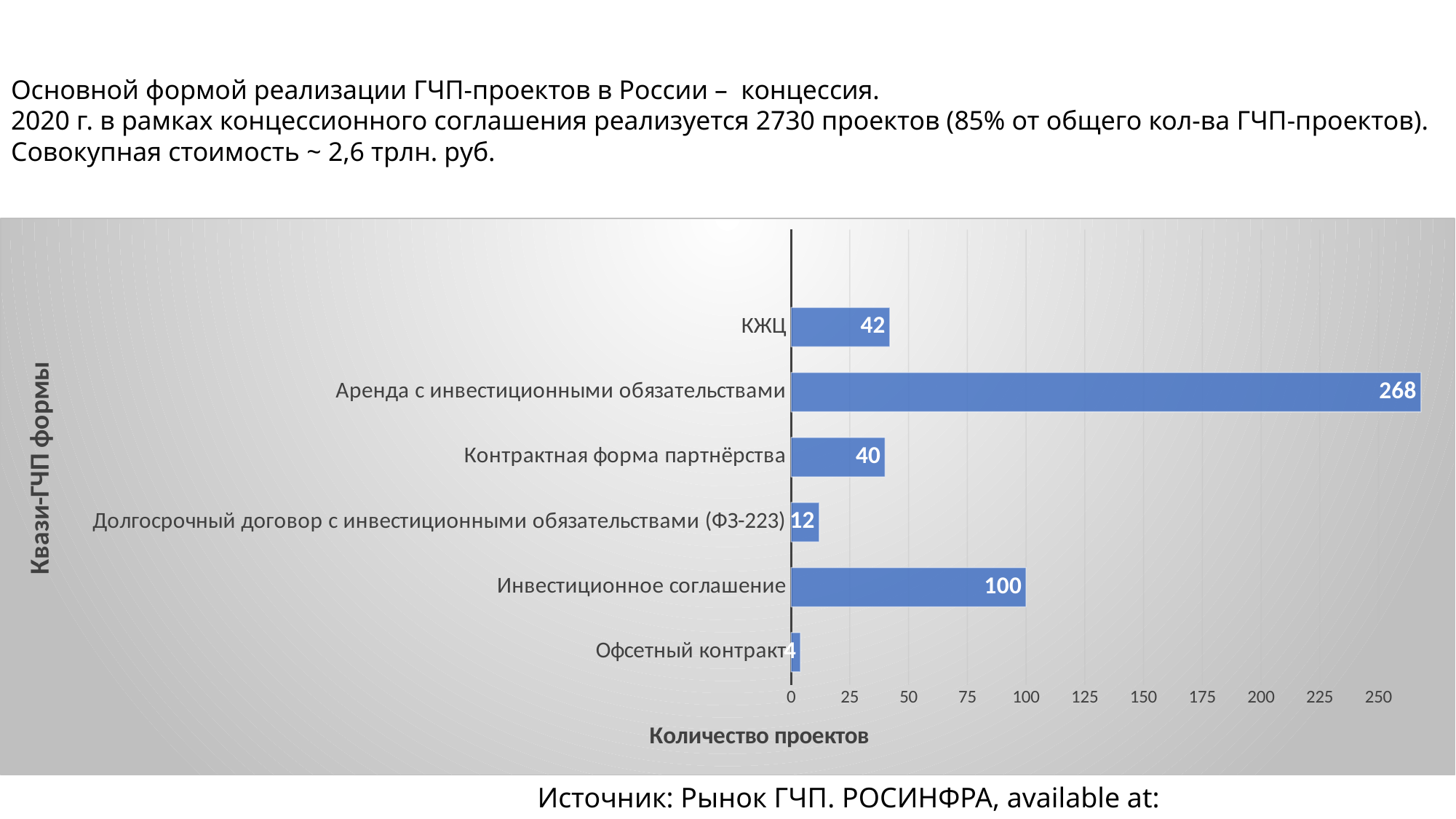
What is the value for КЖЦ? 42 How many projects are shown for Аренда с инвестиционными обязательствами? 268 Which is larger: the value for Инвестиционное соглашение or the value for КЖЦ? Инвестиционное соглашение What is the value for Долгосрочный договор с инвестиционными обязательствами (ФЗ-223)? 12 How many categories are shown on the chart? 6 What kind of chart is shown on the slide? Bar chart What is the difference between the values for КЖЦ and Контрактная форма партнёрства? 2 What is the title of the horizontal axis of the chart? Количество проектов Which quasi-PPP form has the highest number of projects? Аренда с инвестиционными обязательствами What is the difference between the values for Аренда с инвестиционными обязательствами and Инвестиционное соглашение? 168 Which quasi-PPP form has the lowest number of projects? Офсетный контракт What is the value for Инвестиционное соглашение? 100